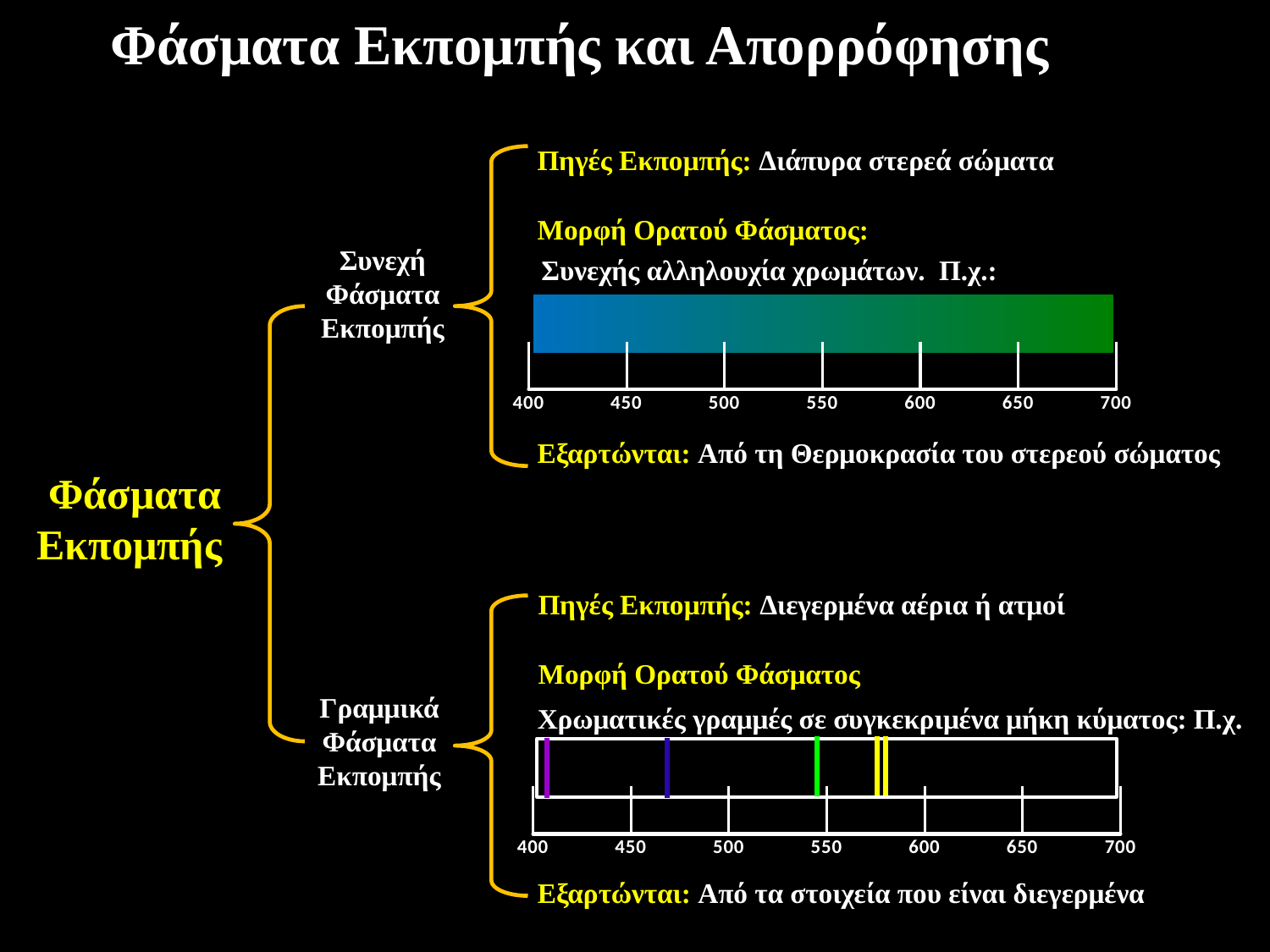
In the bottom spectrum diagram (Γραμμικά Φάσματα Εκπομπής), how many labelled tick marks are on the wavelength axis? 7 In the top spectrum diagram (Συνεχή Φάσματα Εκπομπής), what is the lowest value shown on the wavelength axis? 400 In the bottom spectrum diagram (Γραμμικά Φάσματα Εκπομπής), which colour of line appears twice? yellow In the bottom spectrum diagram (Γραμμικά Φάσματα Εκπομπής), is the blue line at a wavelength greater or less than 500? less In the bottom spectrum diagram (Γραμμικά Φάσματα Εκπομπής), are the yellow lines at wavelengths greater or less than 600? less In the bottom spectrum diagram (Γραμμικά Φάσματα Εκπομπής), how many coloured spectral lines are drawn? 5 In the bottom spectrum diagram (Γραμμικά Φάσματα Εκπομπής), is the purple line at a wavelength greater or less than 450? less In the bottom spectrum diagram (Γραμμικά Φάσματα Εκπομπής), which coloured line is at the shortest wavelength? purple In the top spectrum diagram (Συνεχή Φάσματα Εκπομπής), what is the highest value shown on the wavelength axis? 700